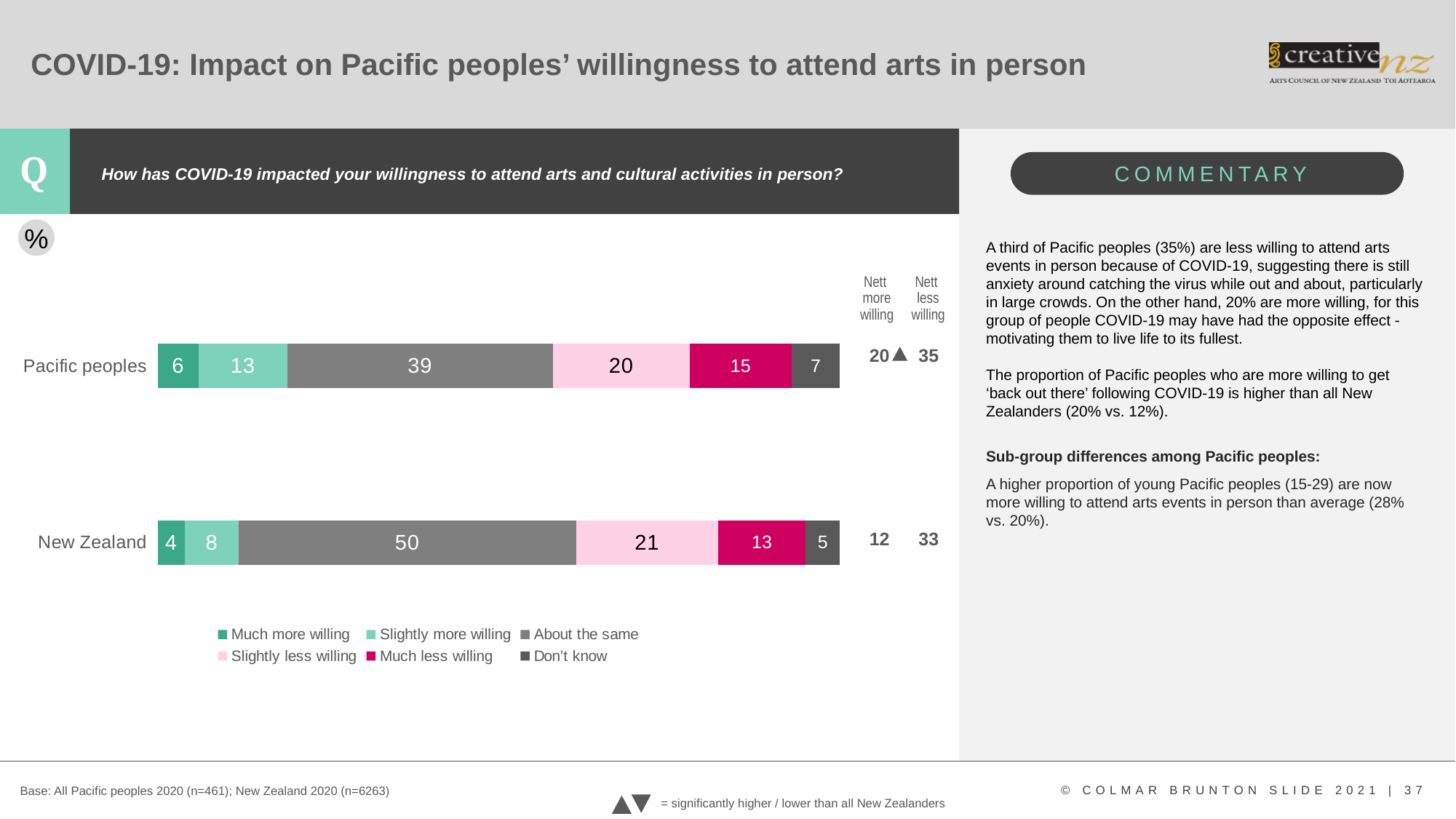
Which has the larger 'Slightly more willing' value, Pacific peoples or New Zealand? Pacific peoples What is the difference between the 'About the same' values for New Zealand and Pacific peoples? 11 What kind of chart is shown on the slide? Stacked bar chart How many categories (bars) are plotted in the chart? 2 What is the 'About the same' value for Pacific peoples? 39 Which segment is the largest in the Pacific peoples bar? About the same What is the 'Nett less willing' figure shown for Pacific peoples? 35 What is the 'Much more willing' value for Pacific peoples? 6 What is the 'Slightly less willing' value for New Zealand? 21 How many series does the legend list? 6 Which segment is the smallest in the New Zealand bar? Much more willing What is the 'Much less willing' value for New Zealand? 13